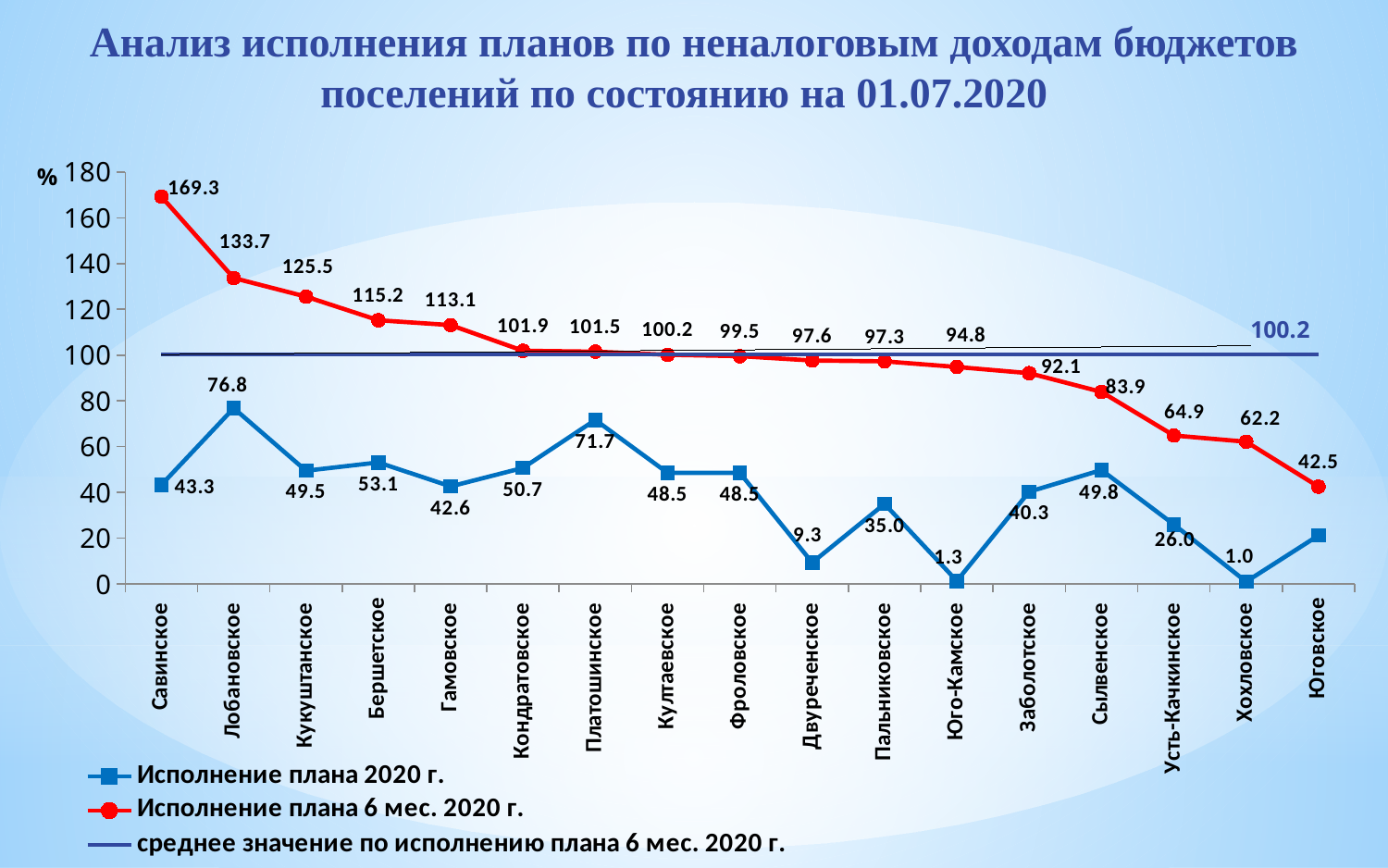
How many series does the legend list? 3 What kind of chart is shown on the slide? line chart What is the value of the 'Исполнение плана 6 мес. 2020 г.' series for Савинское? 169.3 What is the value of the 'Исполнение плана 2020 г.' series for Хохловское? 1.0 In the 'Исполнение плана 2020 г.' series, which is larger: Платошинское or Кондратовское? Платошинское What is the difference between the 'Исполнение плана 6 мес. 2020 г.' values for Савинское and Лобановское? 35.6 What is the value of the 'Исполнение плана 2020 г.' series for Лобановское? 76.8 Which settlement has the lowest value in the 'Исполнение плана 6 мес. 2020 г.' series? Юговское Is the 'Исполнение плана 2020 г.' value for Юговское greater or less than 40? less How many settlements are shown on the x axis? 17 Which settlement has the highest value in the 'Исполнение плана 2020 г.' series? Лобановское Does the 'Исполнение плана 6 мес. 2020 г.' series rise or fall from left to right along the x axis? fall